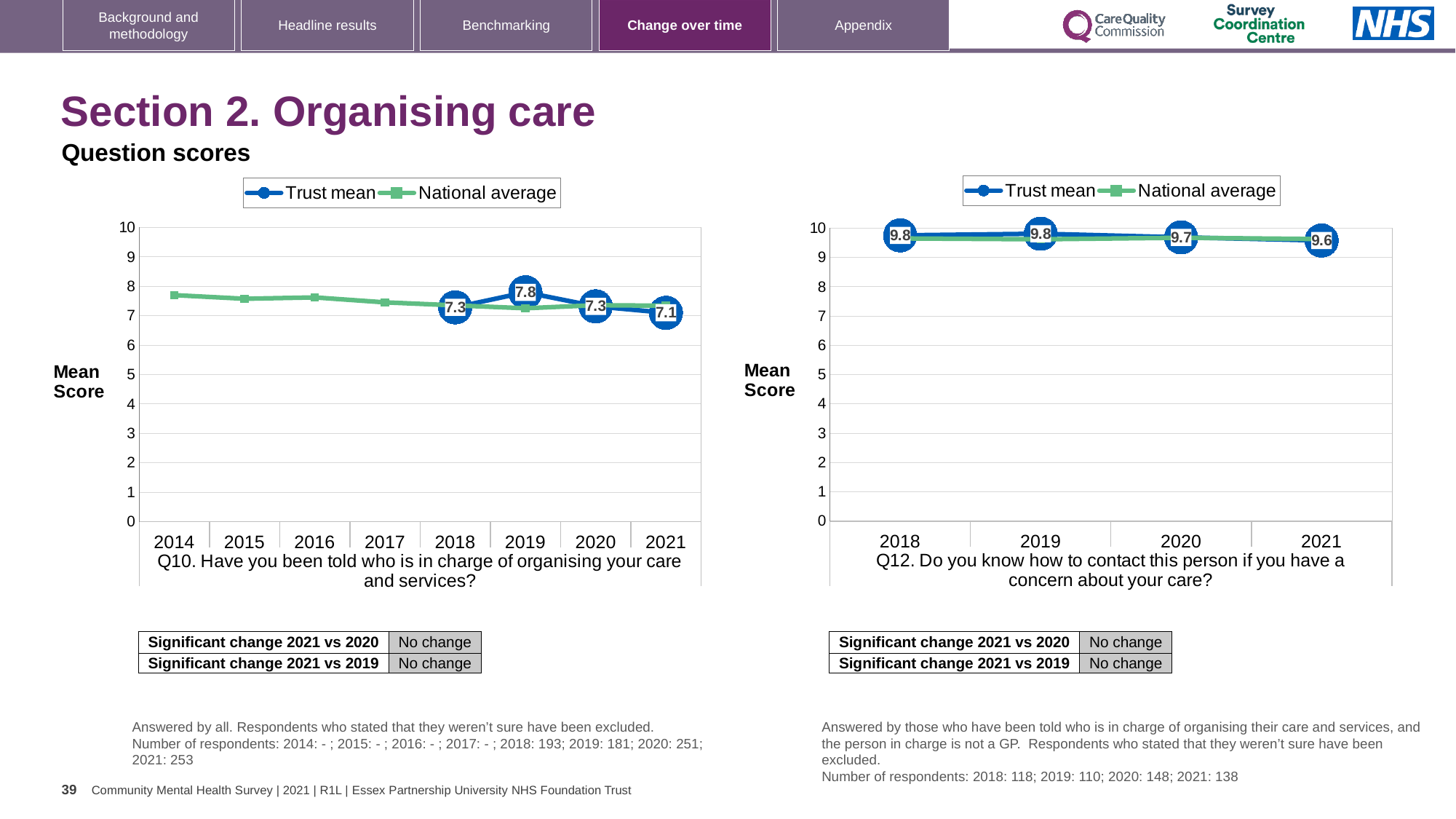
In the Q12 chart on the right, what is the Trust mean for 2021? 9.6 In the Q10 chart on the left, what is the difference between the Trust mean in 2019 and in 2021? 0.7 In the Q10 chart on the left, how many years are shown on the x axis? 8 In the Q10 chart on the left, is the National average for 2014 greater or less than 7? greater In the Q10 chart on the left, which year has the highest Trust mean? 2019 In the Q12 chart on the right, what is the Trust mean for 2020? 9.7 In the Q12 chart on the right, how many series does the legend list? 2 What kind of chart is the Q12 chart on the right? line chart In the Q10 chart on the left, what is the Trust mean for 2021? 7.1 In the Q10 chart on the left, what is the Trust mean for 2019? 7.8 In the Q12 chart on the right, does the Trust mean rise or fall from 2018 to 2021? fall In the Q10 chart on the left, which year has the lowest Trust mean? 2021